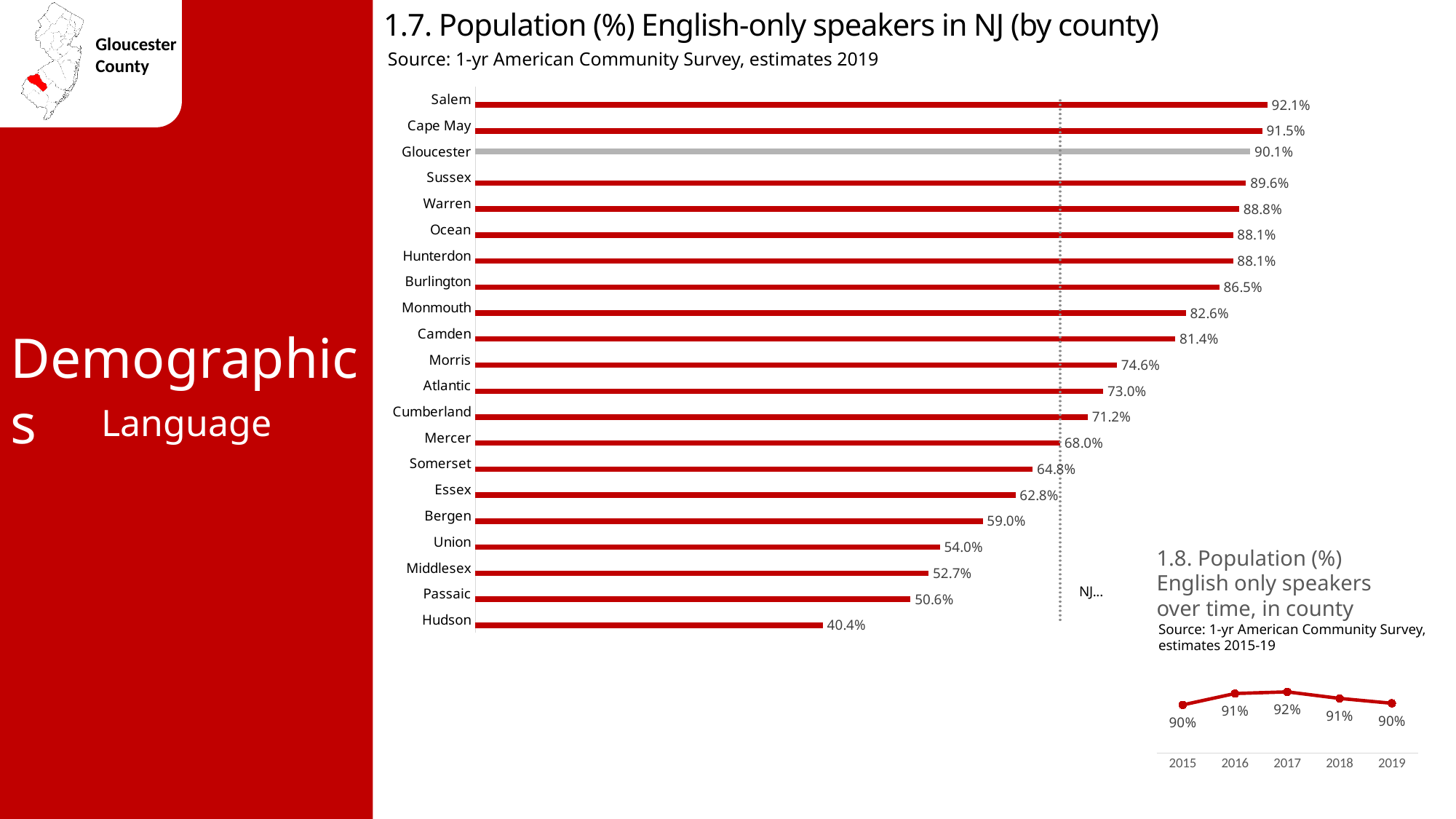
In chart 1.7 (English-only speakers by county), which county's bar is shown in grey instead of red? Gloucester In chart 1.7 (English-only speakers by county), which county has the lowest value? Hudson In chart 1.7 (English-only speakers by county), how many counties are shown? 21 In chart 1.7 (English-only speakers by county), what is the value for Gloucester? 90.1% In chart 1.8 (English only speakers over time), what is the value for 2017? 92% In chart 1.8 (English only speakers over time), which year has the highest value? 2017 In chart 1.7 (English-only speakers by county), which is larger, Camden or Morris? Camden What kind of chart is chart 1.7 (English-only speakers by county)? Bar chart In chart 1.8 (English only speakers over time), how many years are plotted? 5 In chart 1.7 (English-only speakers by county), what is the value for Hudson? 40.4% In chart 1.7 (English-only speakers by county), which county has the highest value? Salem In chart 1.7 (English-only speakers by county), what is the difference between Salem and Gloucester? 2.0%